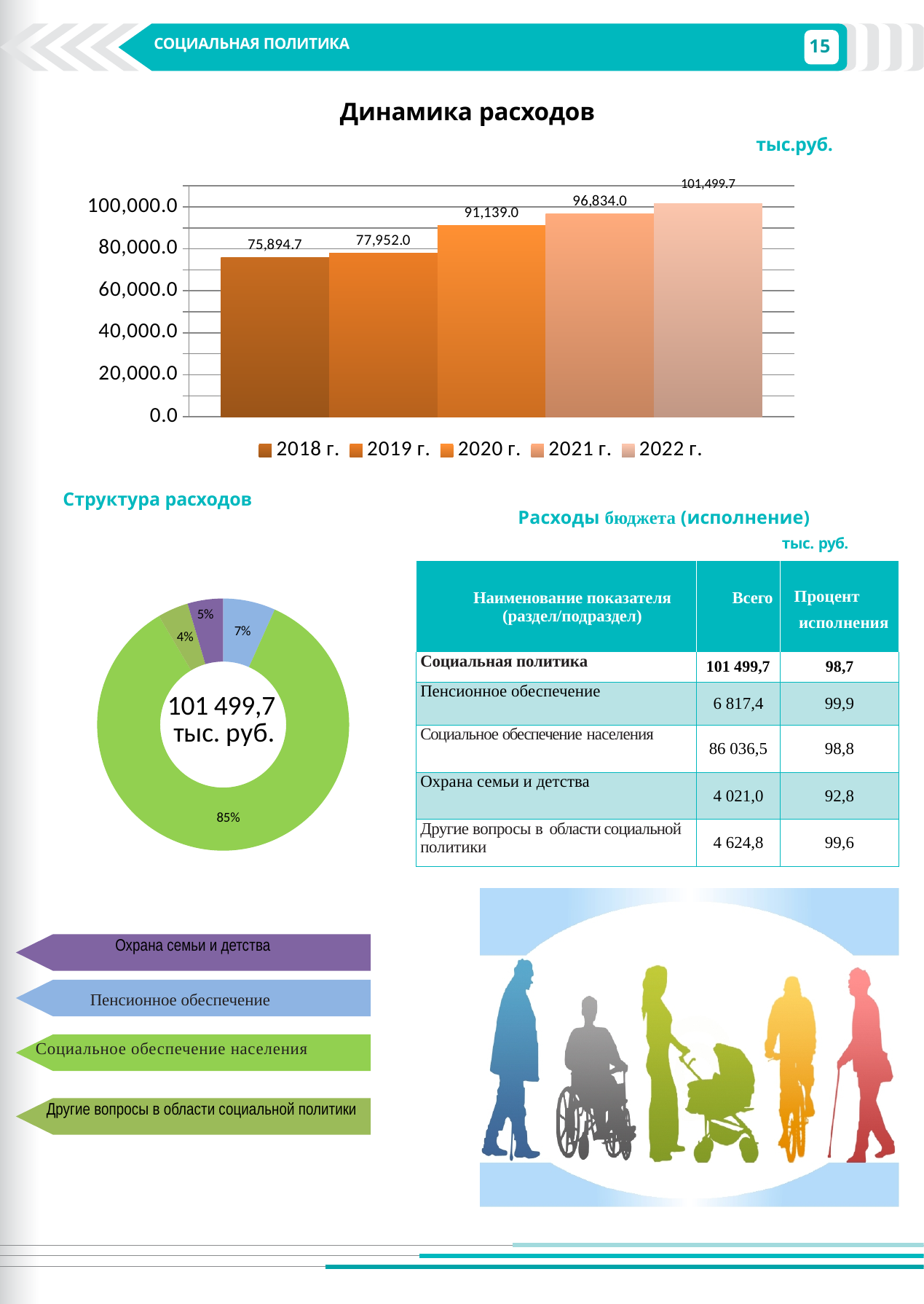
In the 'Динамика расходов' chart, which is larger: the value for 2019 г. or the value for 2020 г.? 2020 г. In the 'Динамика расходов' chart, what is the value for 2018 г.? 75,894.7 In the 'Динамика расходов' chart, which year has the lowest value? 2018 г. In the 'Динамика расходов' chart, is the value for 2021 г. greater or less than 100,000.0? less Do the values in the 'Динамика расходов' chart rise or fall from 2018 г. to 2022 г.? rise In the 'Динамика расходов' chart, which year has the highest value? 2022 г. In the 'Структура расходов' chart, what share does the largest slice have? 85% How many years are shown in the 'Динамика расходов' chart? 5 What kind of chart is 'Динамика расходов'? bar chart In the 'Динамика расходов' chart, what is the value for 2020 г.? 91,139.0 What total value is shown in the centre of the 'Структура расходов' chart? 101 499,7 тыс. руб. In the 'Динамика расходов' chart, what is the difference between the values for 2022 г. and 2021 г.? 4,665.7